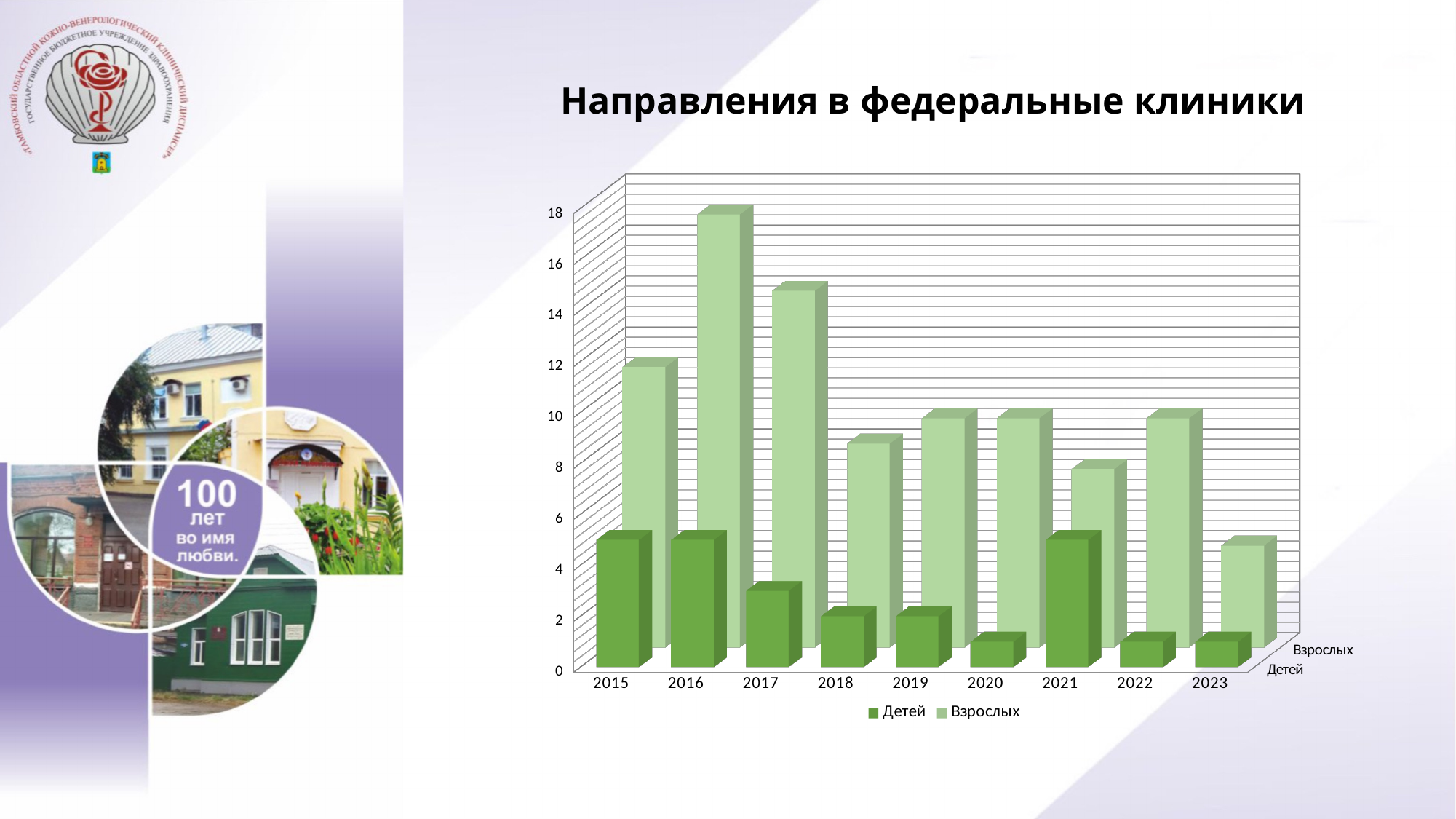
How many series does the legend list? 2 What kind of chart is shown on the slide? bar chart Is the value for Детей in 2017 greater or less than 4? less How many years are shown on the x axis of the chart? 9 Is the value for Взрослых in 2015 greater or less than 10? greater Which year has the lowest value for Взрослых? 2023 Is the value for Взрослых in 2023 greater or less than 6? less Which is larger: the value for Детей in 2017 or in 2018? 2017 Which year has the highest value for Взрослых? 2016 Which is larger: the value for Взрослых in 2015 or in 2021? 2015 What is the title of the chart? Направления в федеральные клиники